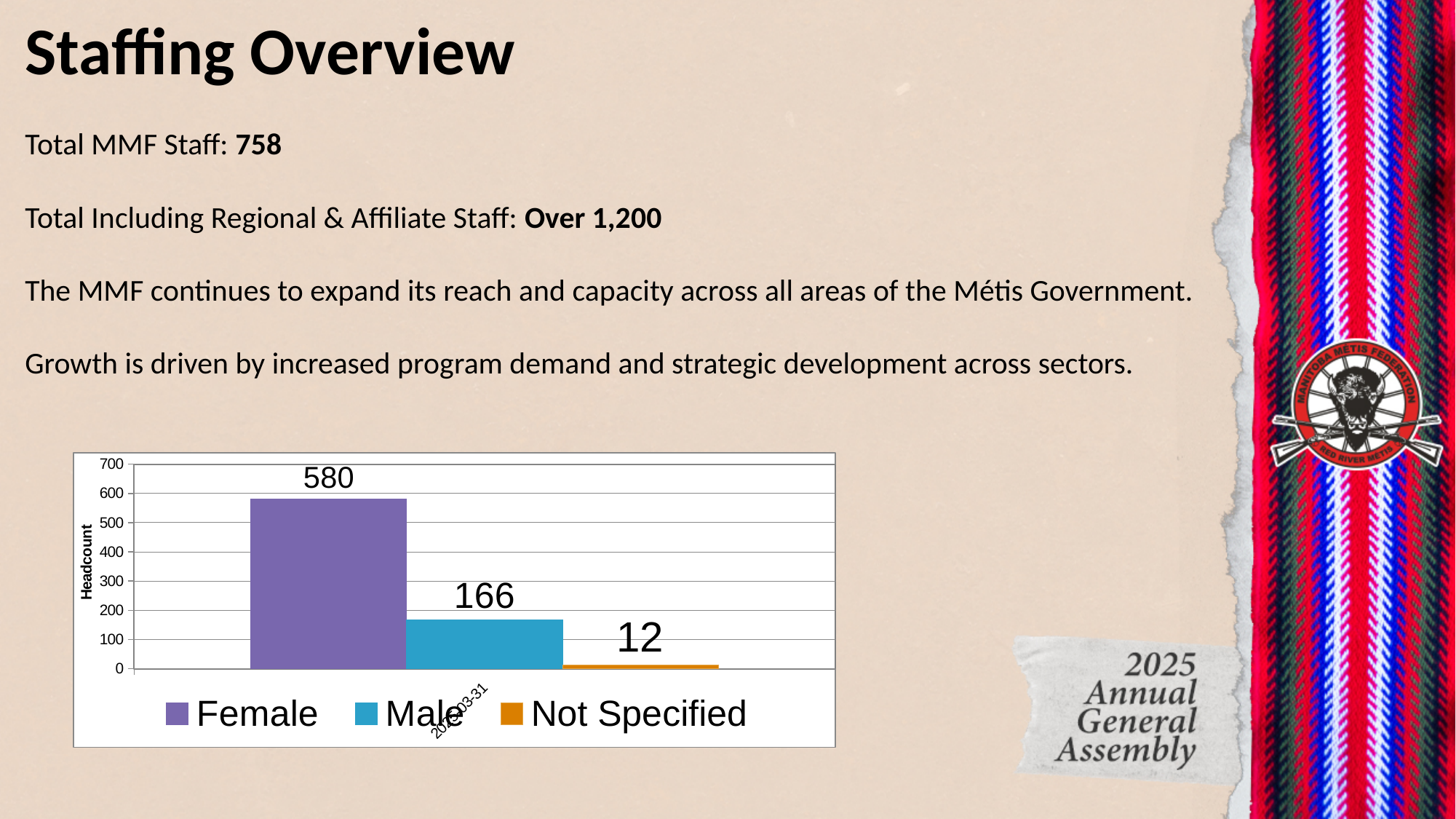
What is the difference between the Male and Not Specified headcounts? 154 How many series does the chart legend list? 3 Which category has the highest headcount in the chart? Female What is the label on the vertical axis of the chart? Headcount Is the value for Male greater or less than 200? less What kind of chart is shown on the slide? bar chart Which category has the lowest headcount in the chart? Not Specified Which is larger, the Male headcount or the Not Specified headcount? Male What is the headcount for the Not Specified category in the chart? 12 What is the difference between the Female and Male headcounts? 414 What is the headcount for Male staff shown in the chart? 166 What is the headcount for Female staff shown in the chart? 580